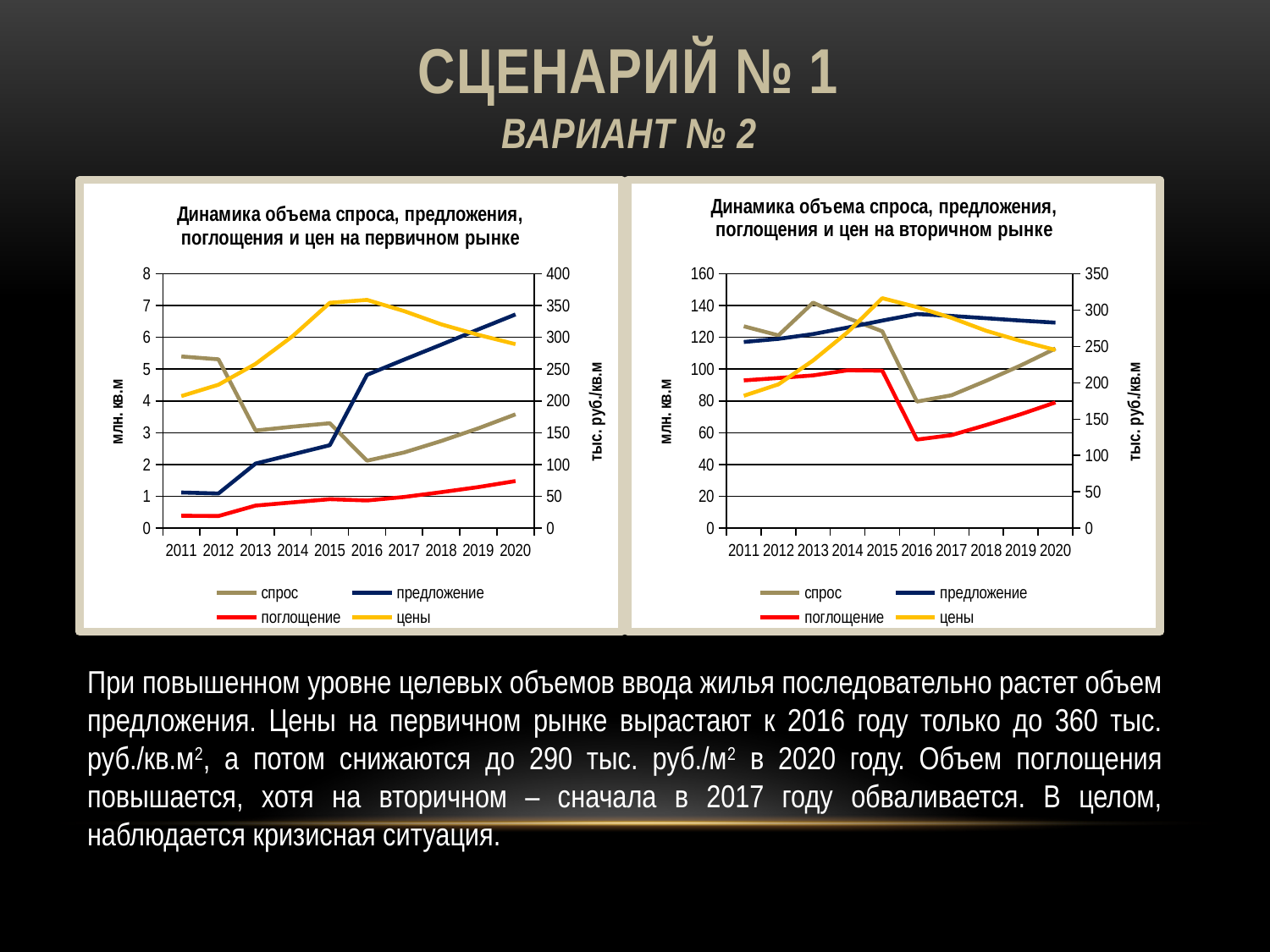
What type of chart is the left chart, 'Динамика объема спроса, предложения, поглощения и цен на первичном рынке'? line chart How many years are shown on the x axis of the left chart ('...на первичном рынке')? 10 How many series does the legend of the right chart ('...на вторичном рынке') list? 4 In the left chart ('...на первичном рынке'), is the value for 'предложение' in 2020 greater or less than 6? greater What is the label of the right-hand vertical axis of the right chart ('...на вторичном рынке')? тыс. руб./кв.м In the left chart ('...на первичном рынке'), does the 'предложение' line rise or fall from 2011 to 2020? rise In the right chart ('...на вторичном рынке'), in which year is 'цены' highest? 2015 In the left chart ('...на первичном рынке'), is the value for 'поглощение' in 2011 greater or less than 1? less In the right chart ('...на вторичном рынке'), which is larger in 2013: 'спрос' or 'предложение'? спрос In the left chart ('...на первичном рынке'), which is larger in 2020: 'спрос' or 'предложение'? предложение In the left chart ('...на первичном рынке'), in which year is 'спрос' lowest? 2016 In the right chart ('...на вторичном рынке'), is the value for 'спрос' in 2016 greater or less than 100? less